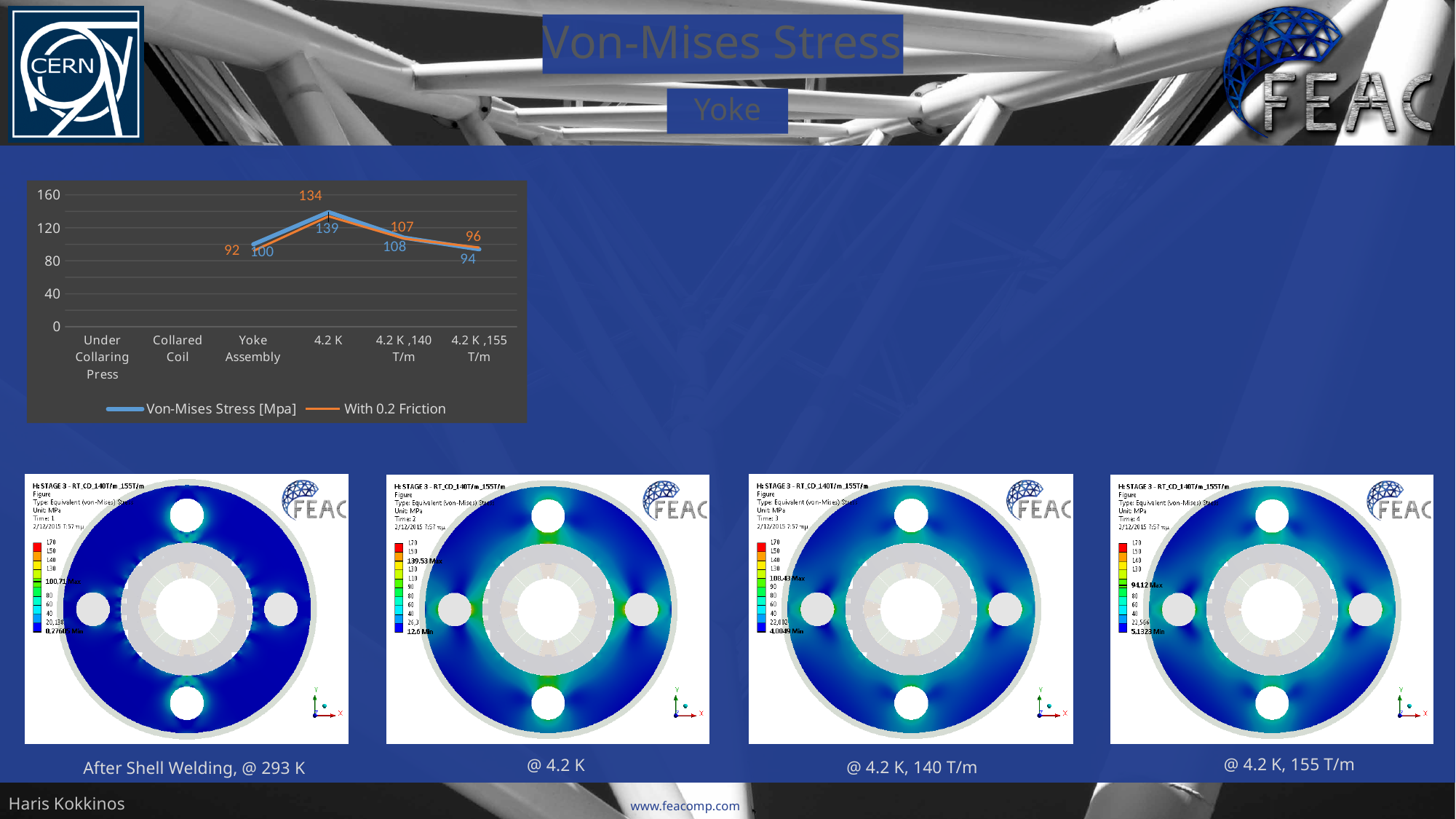
What is the difference between the Von-Mises Stress [Mpa] value and the With 0.2 Friction value at Yoke Assembly? 8 What is the Von-Mises Stress [Mpa] value at 4.2 K ,155 T/m? 94 What is the With 0.2 Friction value at 4.2 K ,140 T/m? 107 At which category does the Von-Mises Stress [Mpa] series reach its highest value? 4.2 K How many series does the chart legend list? 2 How many categories are labelled on the x axis of the chart? 6 At which category is the With 0.2 Friction series lowest? Yoke Assembly What type of chart is shown on the slide? line chart What is the With 0.2 Friction value at Yoke Assembly? 92 Which is larger at 4.2 K ,155 T/m: the Von-Mises Stress [Mpa] value or the With 0.2 Friction value? With 0.2 Friction Does the Von-Mises Stress [Mpa] series rise or fall from 4.2 K to 4.2 K ,155 T/m? fall What is the Von-Mises Stress [Mpa] value at 4.2 K? 139